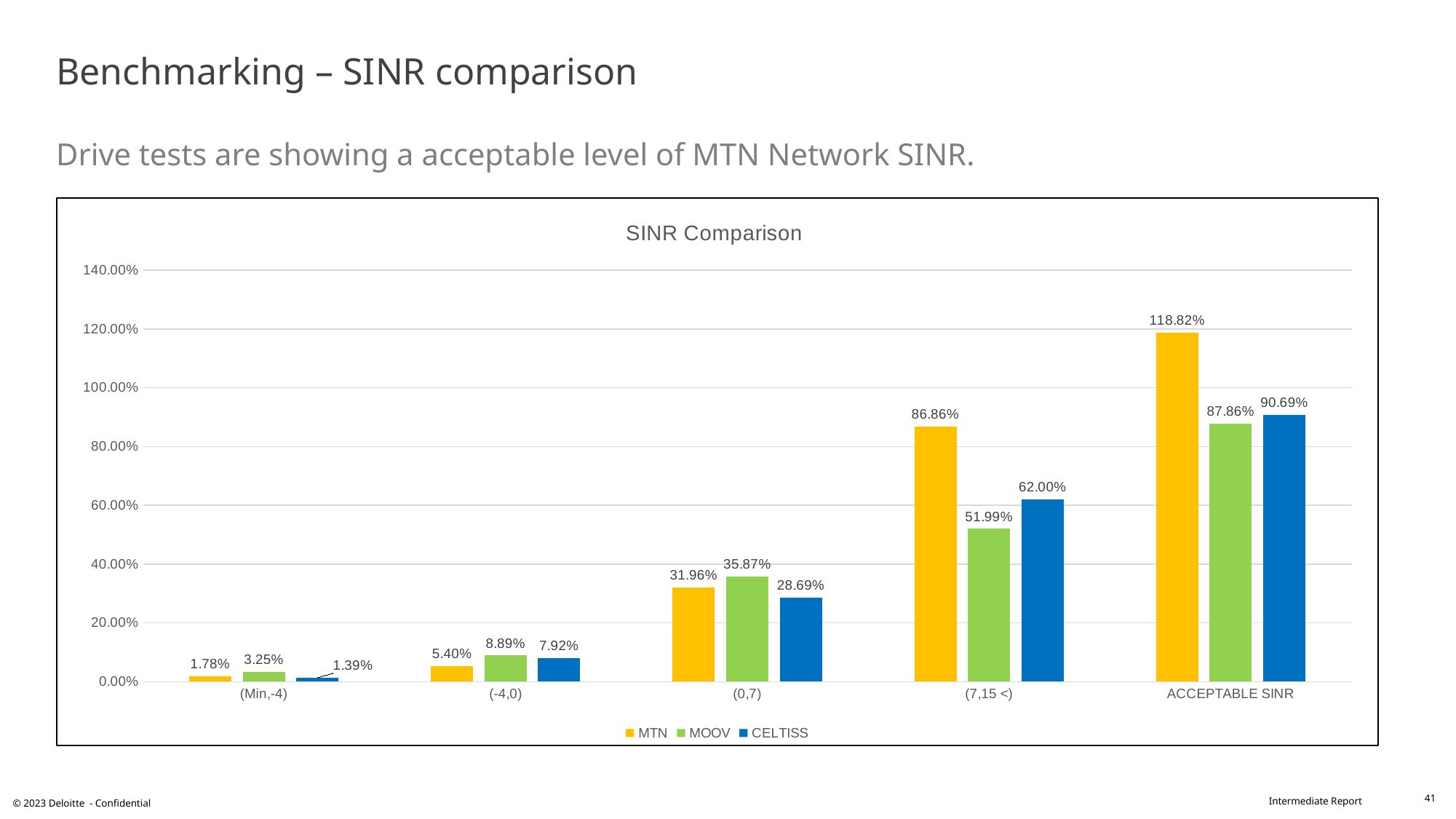
What is the MTN value for the ACCEPTABLE SINR category? 118.82% Is the MTN value for ACCEPTABLE SINR greater or less than 100.00%? greater What is the difference between the MTN and MOOV values for the (7,15 <) category? 34.87% What is the CELTISS value for the (7,15 <) category? 62.00% What is the title of the chart? SINR Comparison Which is larger in the (0,7) category, the MTN value or the CELTISS value? MTN What is the MOOV value for the (0,7) category? 35.87% Which category has the lowest CELTISS value? (Min,-4) Which category has the highest MTN value? ACCEPTABLE SINR How many series does the legend list? 3 How many categories are shown on the x axis? 5 What kind of chart is shown on the slide? Bar chart